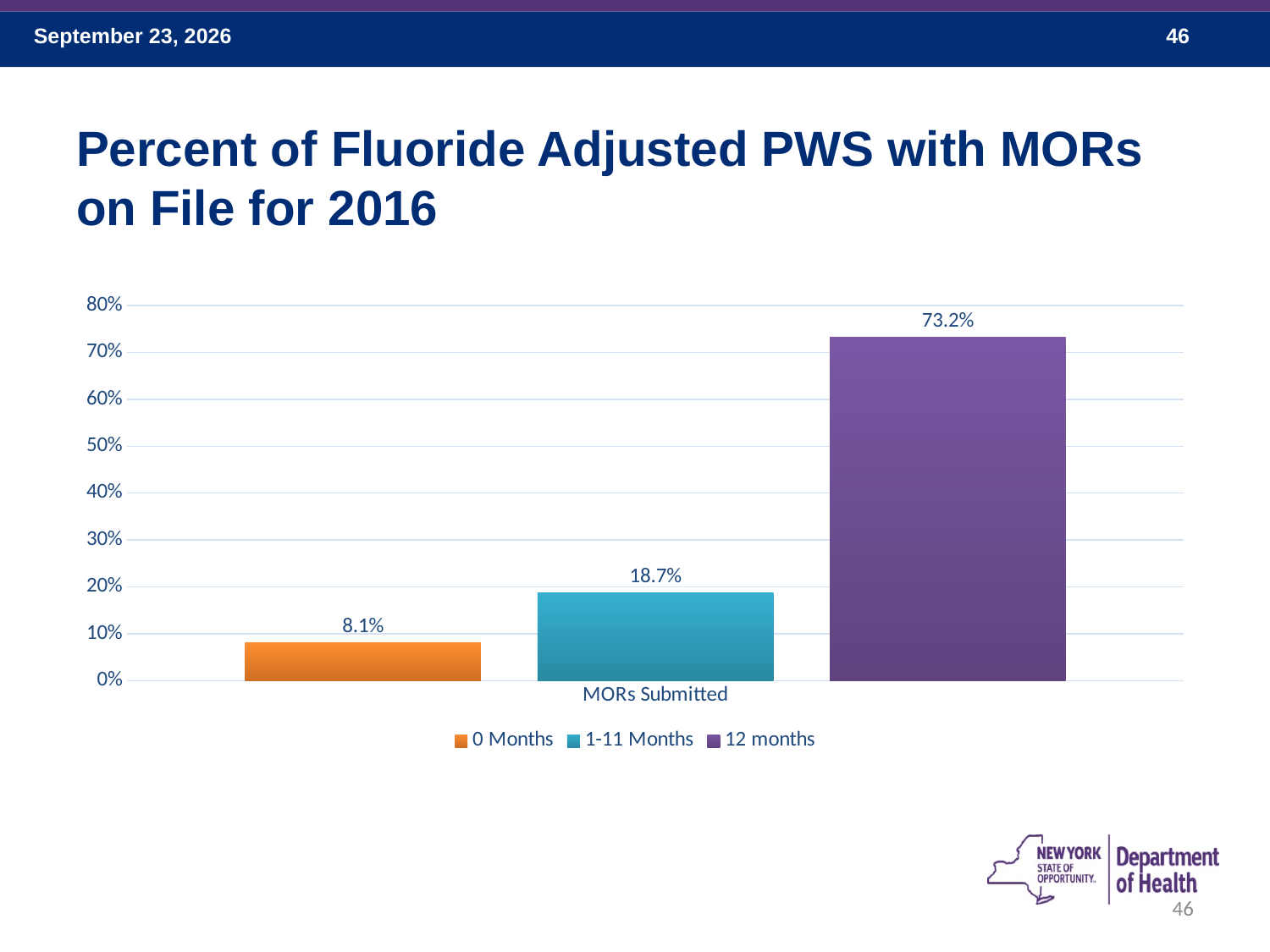
What is the value for 12 months? 73.2% What is the value for 1-11 Months? 18.7% Which is larger, the value for 1-11 Months or the value for 0 Months? 1-11 Months What kind of chart is shown on the slide? bar chart What is the value for 0 Months? 8.1% Is the value for 12 months greater or less than 70%? greater Which series has the lowest value? 0 Months What is the difference between the values for 12 months and 1-11 Months? 54.5% What is the label on the x axis of the chart? MORs Submitted Which series has the highest value? 12 months What is the difference between the values for 1-11 Months and 0 Months? 10.6% How many series does the legend list? 3